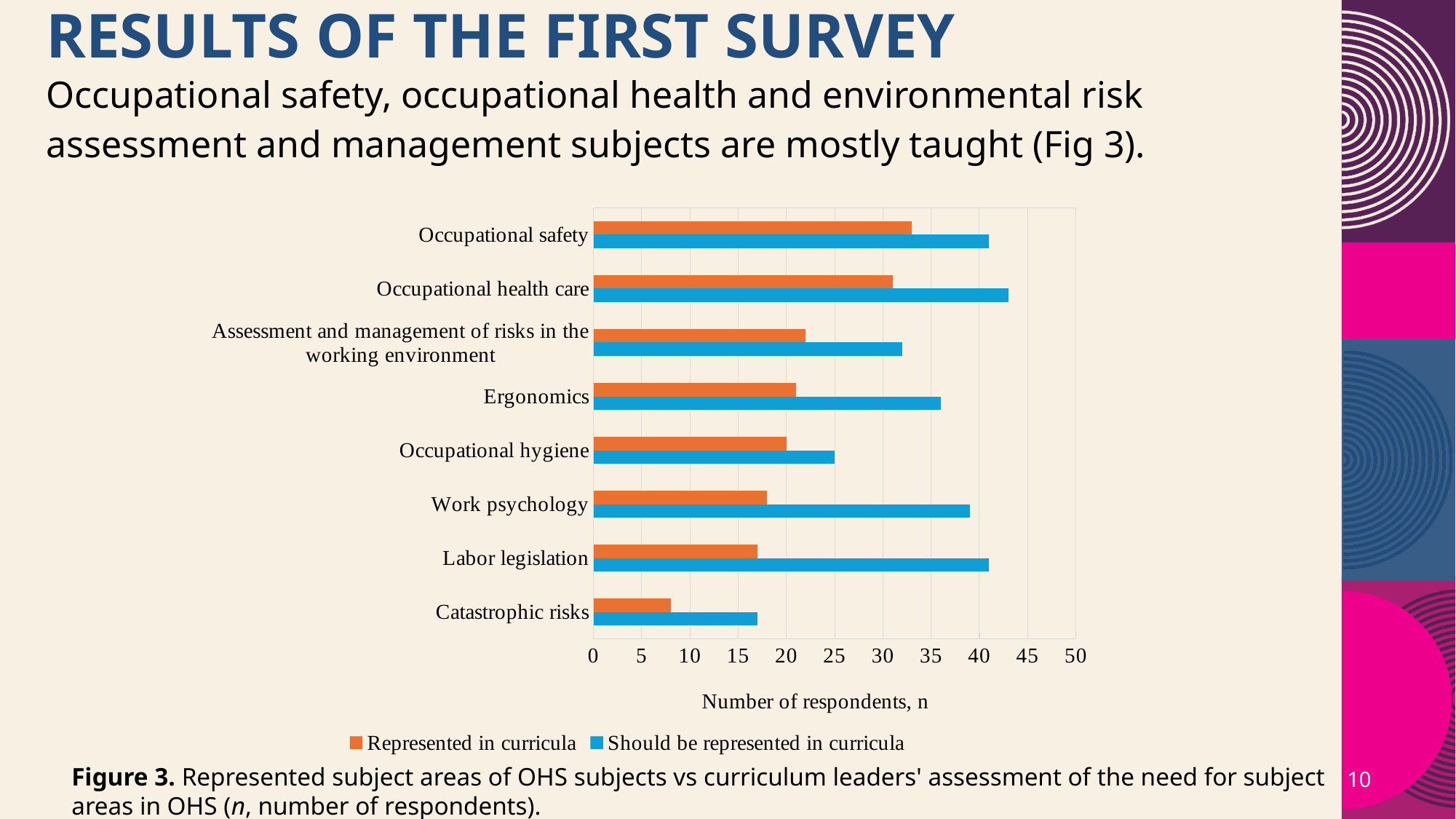
What is the title of the horizontal axis of the chart? Number of respondents, n Which subject area has the lowest value for 'Represented in curricula'? Catastrophic risks Is the 'Should be represented in curricula' value for Ergonomics greater or less than 30? greater For Work psychology, which is larger: 'Represented in curricula' or 'Should be represented in curricula'? Should be represented in curricula How many subject areas (categories) are plotted in the chart? 8 Is the 'Represented in curricula' value for Catastrophic risks greater or less than 10? less Which subject area has the lowest value for 'Should be represented in curricula'? Catastrophic risks How many series does the chart legend list? 2 What kind of chart is shown on the slide? bar chart Is the 'Represented in curricula' value for Work psychology greater or less than 20? less Which is larger: the 'Represented in curricula' value for Occupational safety or for Catastrophic risks? Occupational safety